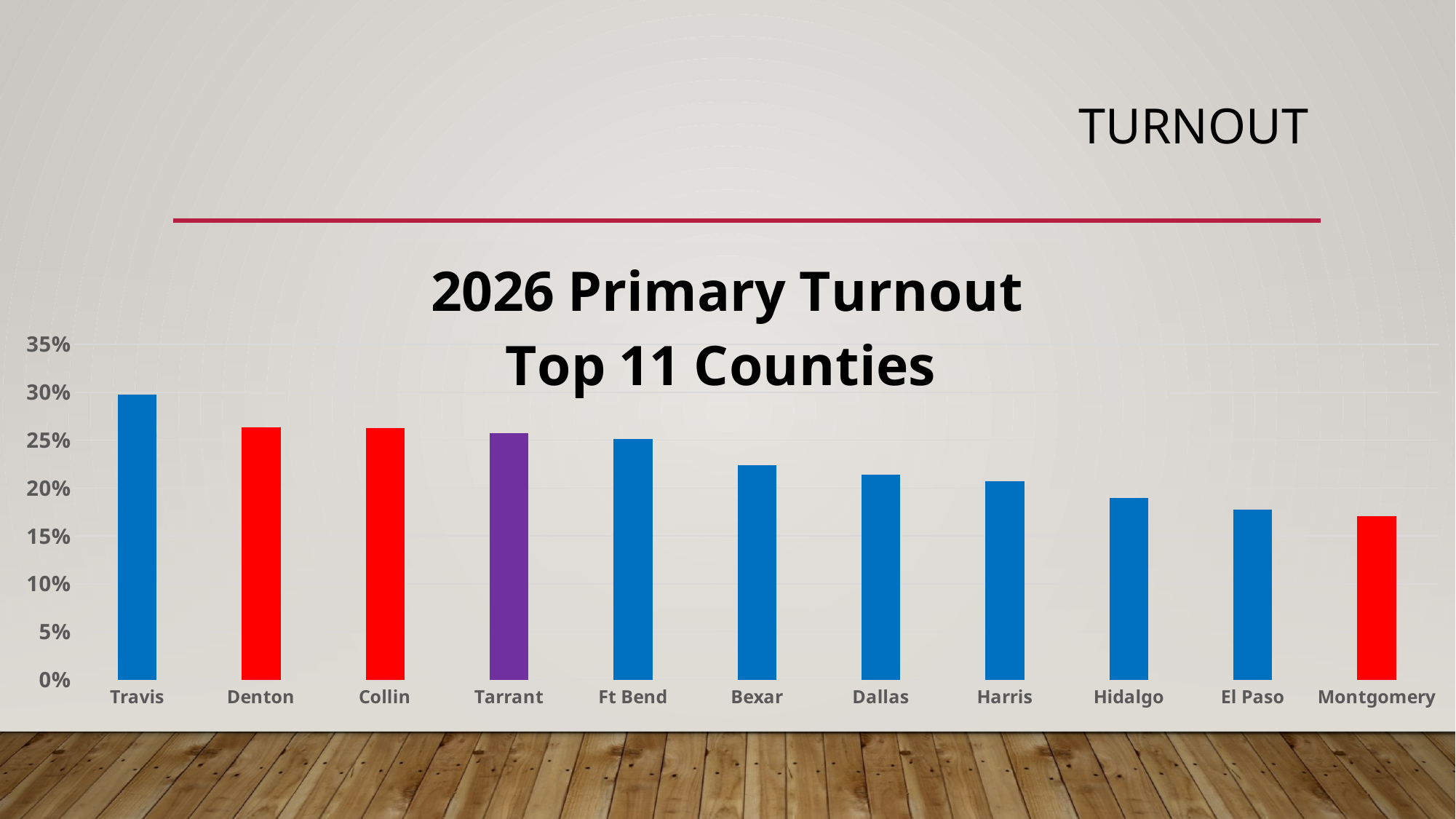
How many counties are shown in the chart? 11 Is the turnout for Travis greater or less than 25%? greater Is the turnout for Hidalgo greater or less than 20%? less What is the title of the chart? 2026 Primary Turnout Top 11 Counties Which has a higher turnout, Bexar or Harris? Bexar Is the turnout for Bexar greater or less than 20%? greater Which county has the highest turnout in the chart? Travis Do the turnout values rise or fall from left to right across the counties? Fall What kind of chart is shown on the slide? Bar chart Which county has the lowest turnout in the chart? Montgomery Which has a higher turnout, Travis or Denton? Travis